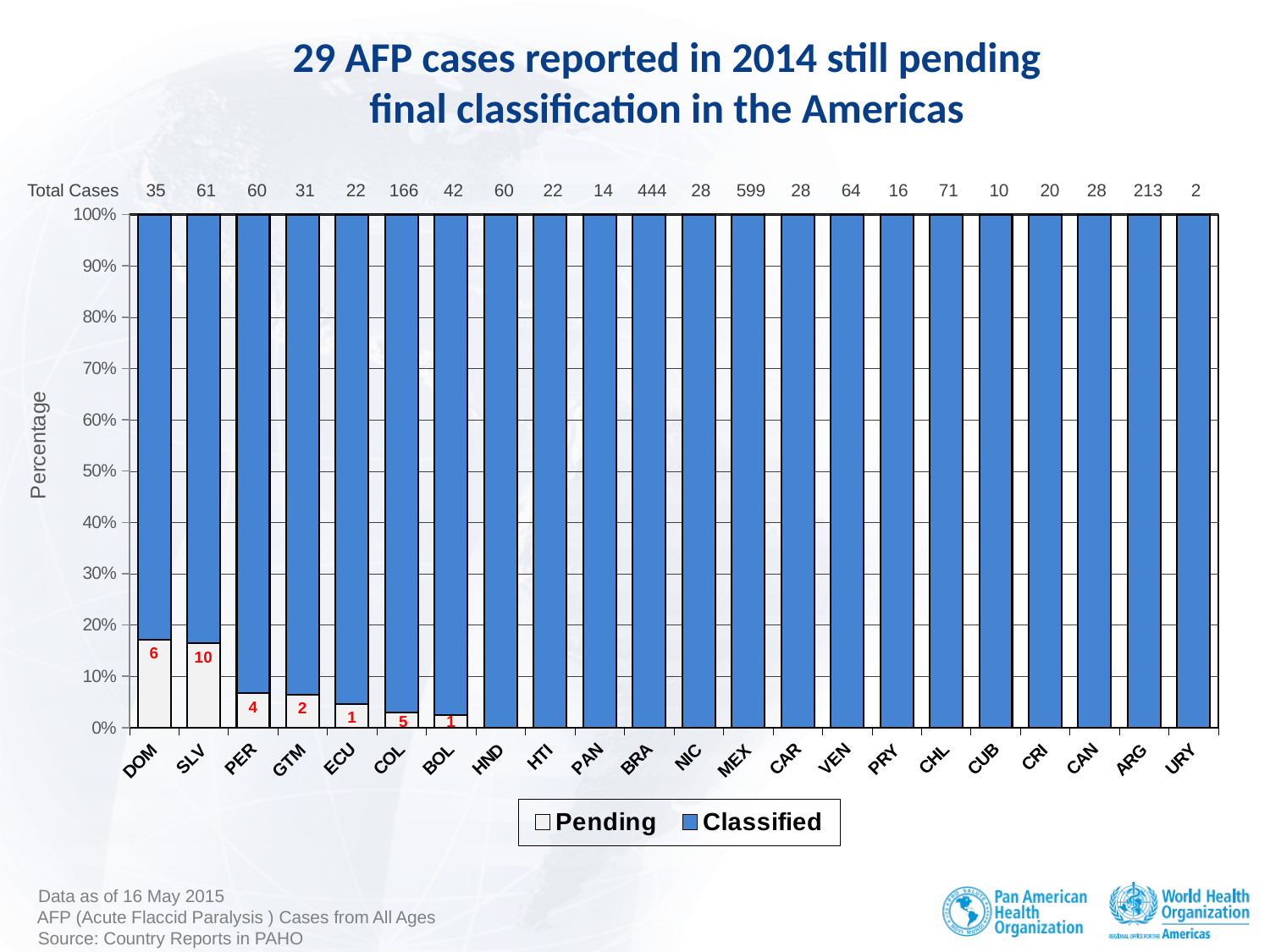
What kind of chart is shown on the slide? Stacked bar chart Which country has the largest number of pending cases? SLV What are the two entries in the legend? Pending and Classified What is the total number of cases shown for MEX? 599 Which country has the lowest total number of cases? URY Is the pending share for DOM greater or less than 10%? greater How many countries are shown along the x axis? 22 How many pending AFP cases are labelled for SLV? 10 What is the difference between the total cases for BRA and ARG? 231 How many series does the legend list? 2 Is the pending share for PER greater or less than 10%? less Which country has the highest total number of cases? MEX